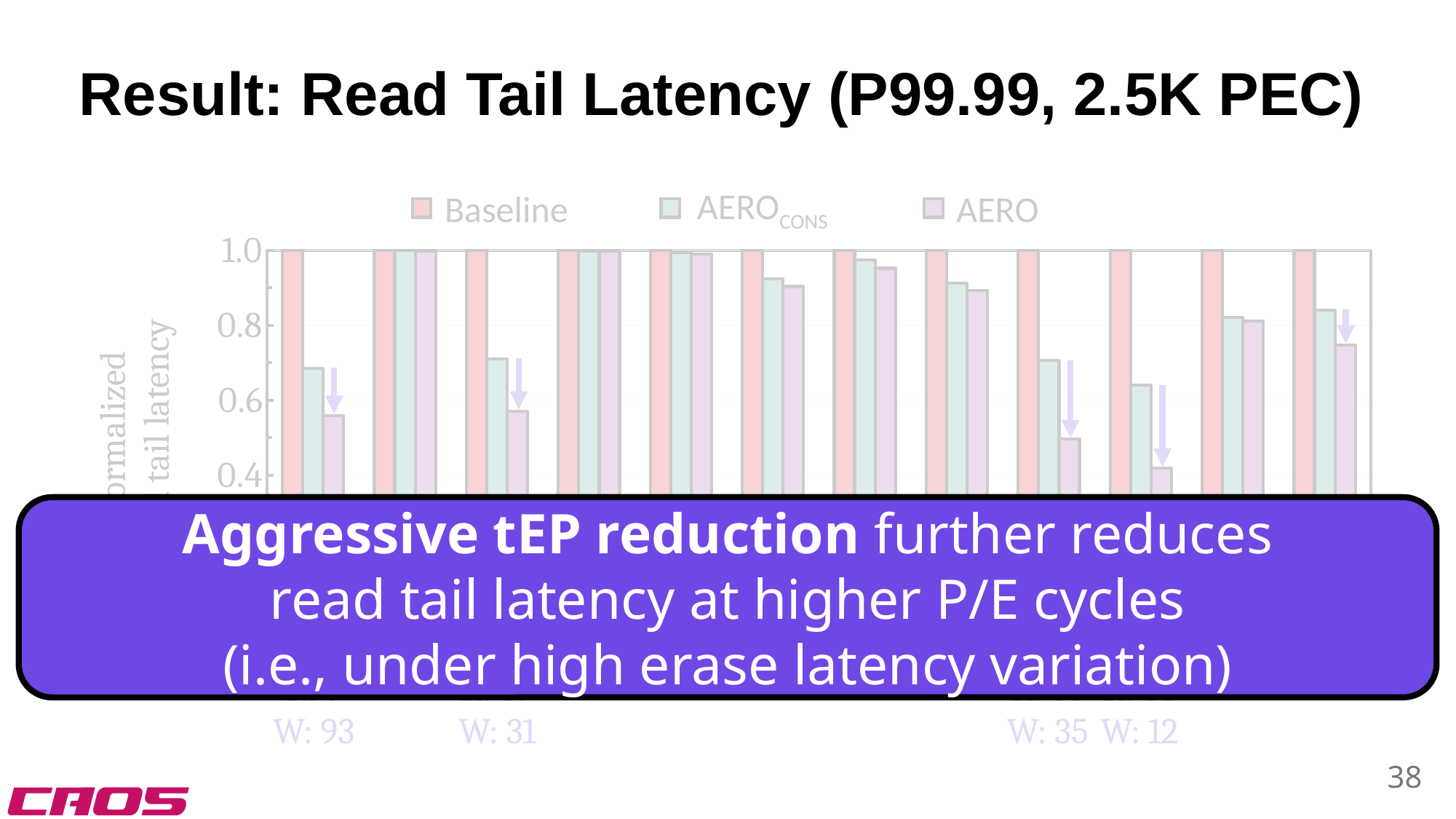
In the leftmost group of bars, which series has the lowest value? AERO What are the three series named in the chart legend? Baseline, AERO_CONS, AERO In the leftmost group of bars, which is larger: the Baseline value or the AERO value? Baseline In the rightmost group of bars, is the AERO value greater or less than 0.8? less What value do the Baseline bars reach in every group of the chart? 1.0 How many groups of bars are plotted in the chart? 12 In the leftmost group of bars, which series has the highest value? Baseline What kind of chart is shown on the slide? bar chart In the third group of bars from the left, is the AERO value greater or less than 0.8? less How many series does the chart legend list? 3 What is the highest tick value shown on the y axis of the chart? 1.0 In the leftmost group of bars, is the AERO_CONS value greater or less than 0.6? greater